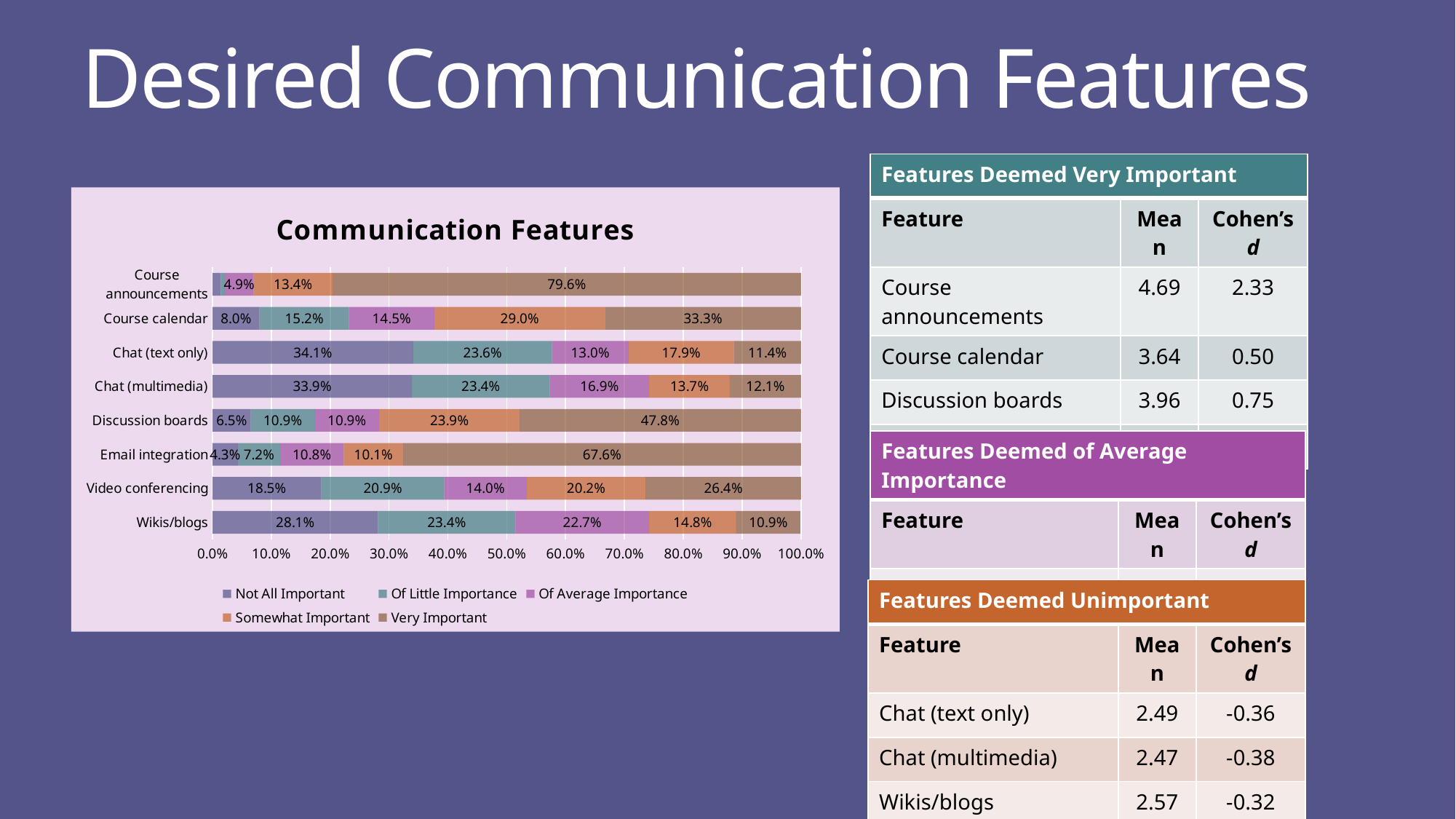
What is the title of the chart on the slide? Communication Features In the "Communication Features" chart, which feature has the highest Very Important percentage? Course announcements In the "Communication Features" chart, what is the Very Important percentage for Email integration? 67.6% In the "Communication Features" chart, which has the larger Not All Important percentage: Video conferencing or Wikis/blogs? Wikis/blogs In the "Communication Features" chart, what is the Somewhat Important percentage for Course calendar? 29.0% In the "Communication Features" chart, how much higher is the Very Important percentage for Discussion boards than for Course calendar? 14.5 percentage points In the "Communication Features" chart, what percentage rated Chat (text only) as Not All Important? 34.1% How many series does the legend of the "Communication Features" chart list? 5 In the "Communication Features" chart, what percentage rated Course announcements as Very Important? 79.6% In the "Communication Features" chart, which feature has the lowest Very Important percentage? Wikis/blogs What kind of chart is the "Communication Features" chart? Stacked bar chart How many communication features (categories) are plotted in the "Communication Features" chart? 8